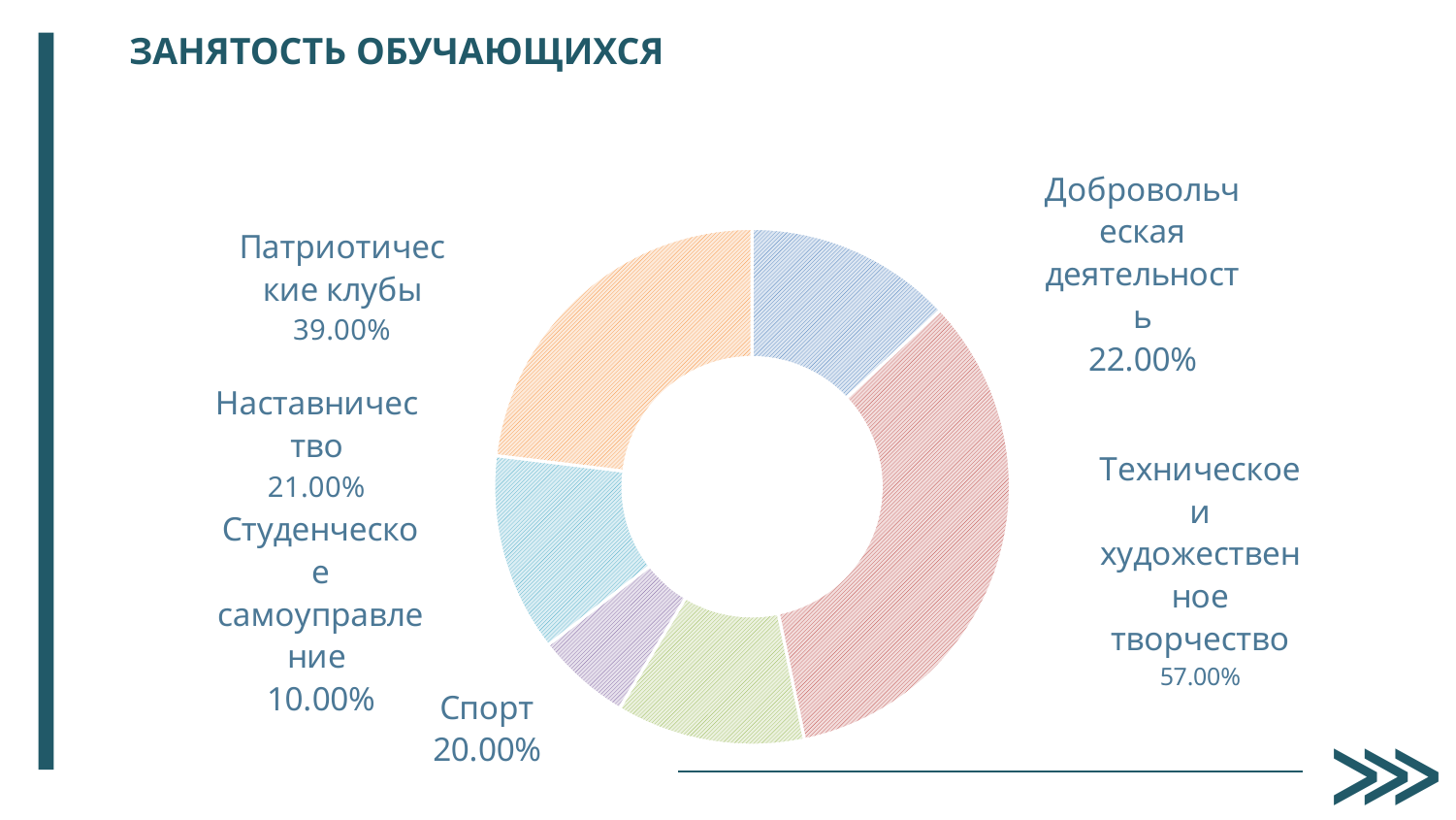
What value is shown for Добровольческая деятельность? 22.00% What is the title of the chart on the slide? ЗАНЯТОСТЬ ОБУЧАЮЩИХСЯ What value is shown for Студенческое самоуправление? 10.00% Which category has the highest value? Техническое и художественное творчество What value is shown for Патриотические клубы? 39.00% How many categories does the chart show? 6 What is the difference between the values for Техническое и художественное творчество and Патриотические клубы? 18.00% What kind of chart is shown on the slide? Doughnut chart Which category has the lowest value? Студенческое самоуправление What value is shown for Спорт? 20.00% What value is shown for Наставничество? 21.00% Which is larger, the value for Спорт or the value for Наставничество? Наставничество